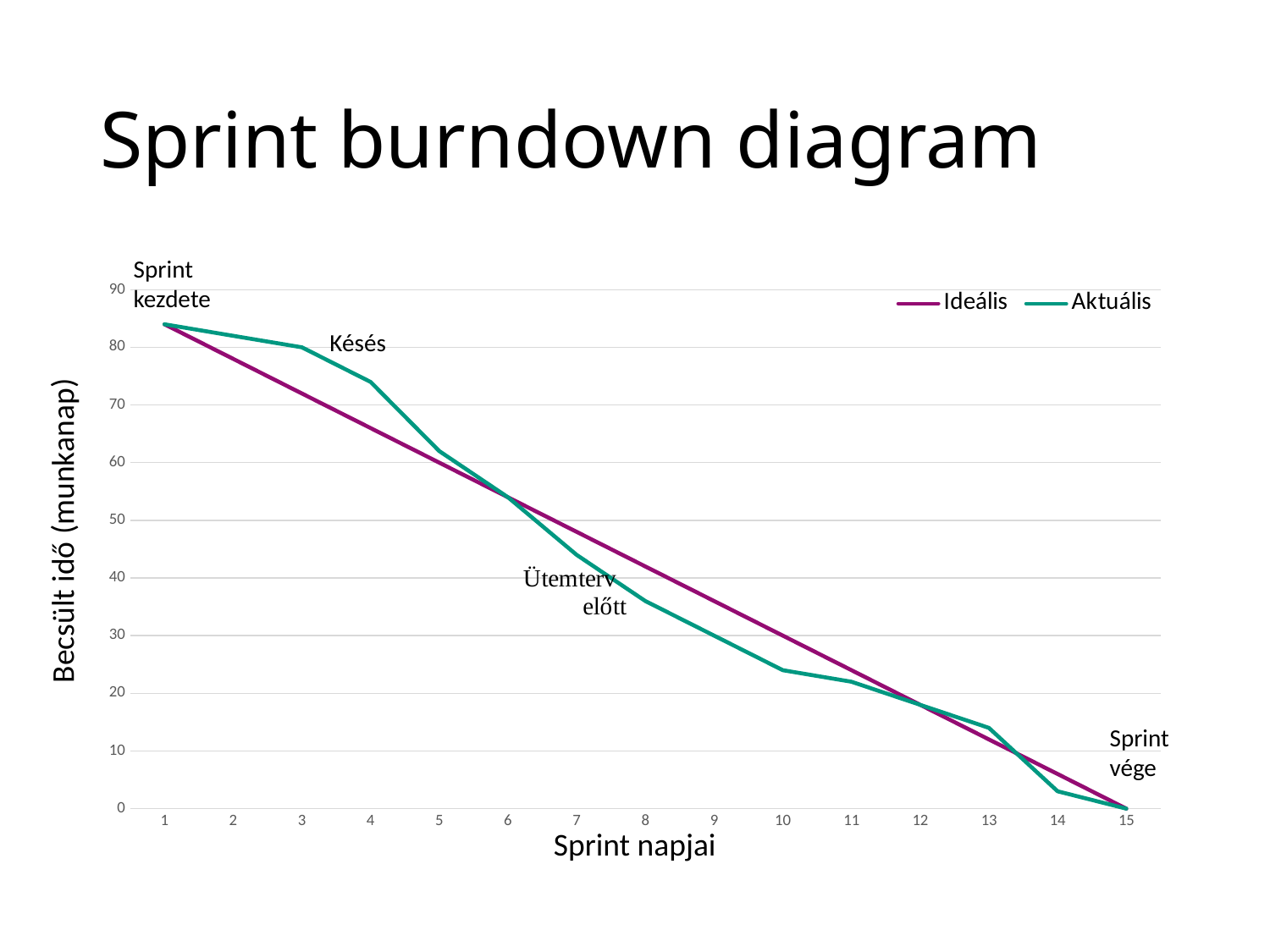
What kind of chart is shown on the slide? line chart On day 8, which series has the higher value, Ideális or Aktuális? Ideális Is the value of the Aktuális series on day 10 greater or less than 30? less Do the values of the Aktuális series rise or fall from day 1 to day 15? fall What is the value of the Aktuális series on day 15? 0 How many series does the legend list? 2 What is the value of the Ideális series on day 15? 0 Is the value of the Ideális series on day 1 greater or less than 80? greater Is the value of the Aktuális series on day 4 greater or less than 70? greater How many sprint days are shown along the x axis? 15 What is the title of the y axis? Becsült idő (munkanap) On day 3, which series has the higher value, Ideális or Aktuális? Aktuális